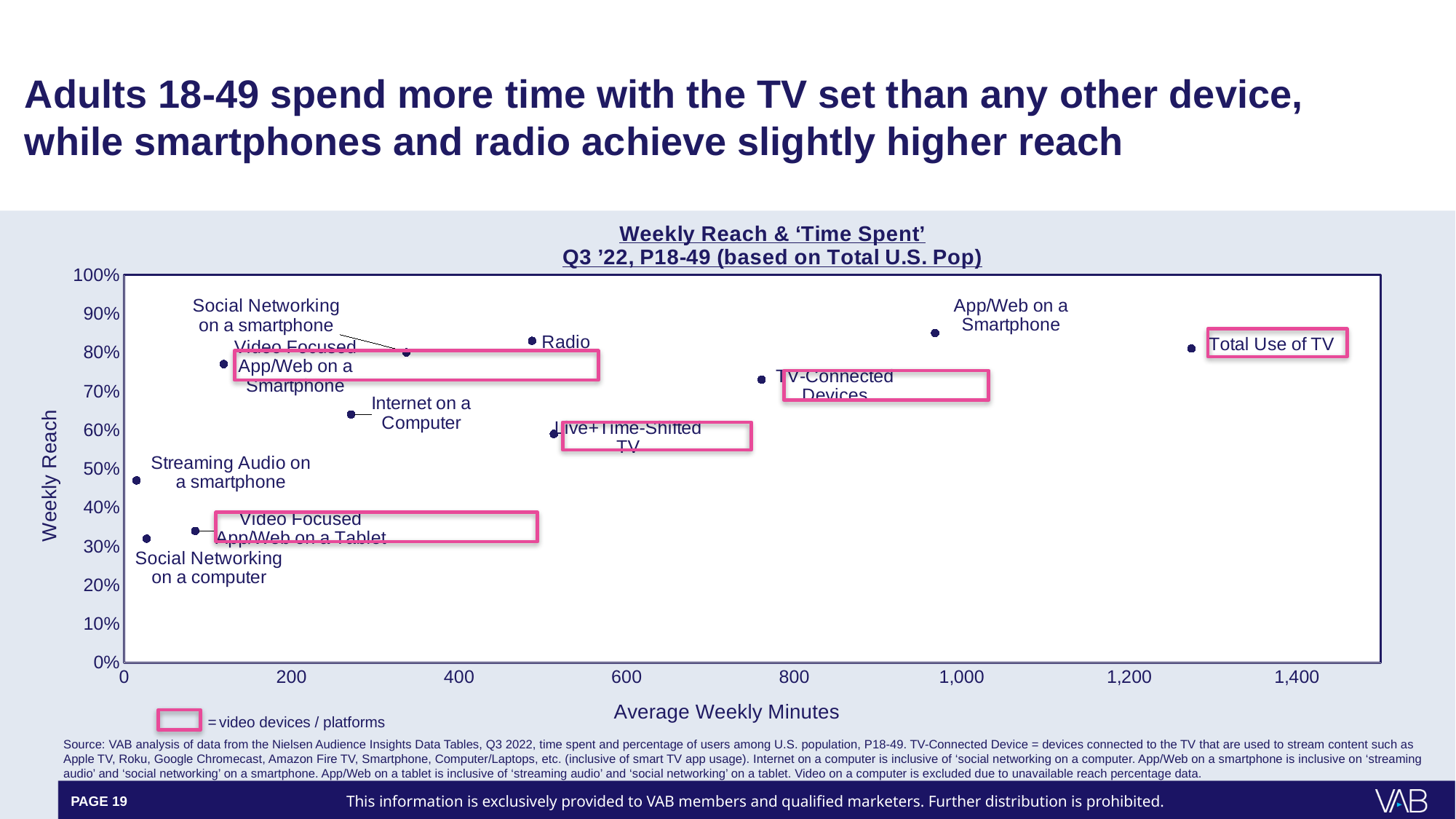
Is the weekly reach for Internet on a Computer greater or less than 60%? greater How many data points are plotted on the chart? 11 Is the average weekly minutes value for Radio greater or less than 400? greater What kind of chart is shown on the slide? Scatter chart What is the label of the x axis? Average Weekly Minutes Which has a higher weekly reach, Radio or Internet on a Computer? Radio Is the weekly reach for TV-Connected Devices greater or less than 70%? greater Which device/platform has the highest average weekly minutes? Total Use of TV Which has more average weekly minutes, Total Use of TV or TV-Connected Devices? Total Use of TV According to the key below the chart, what do the pink boxes around labels indicate? video devices / platforms